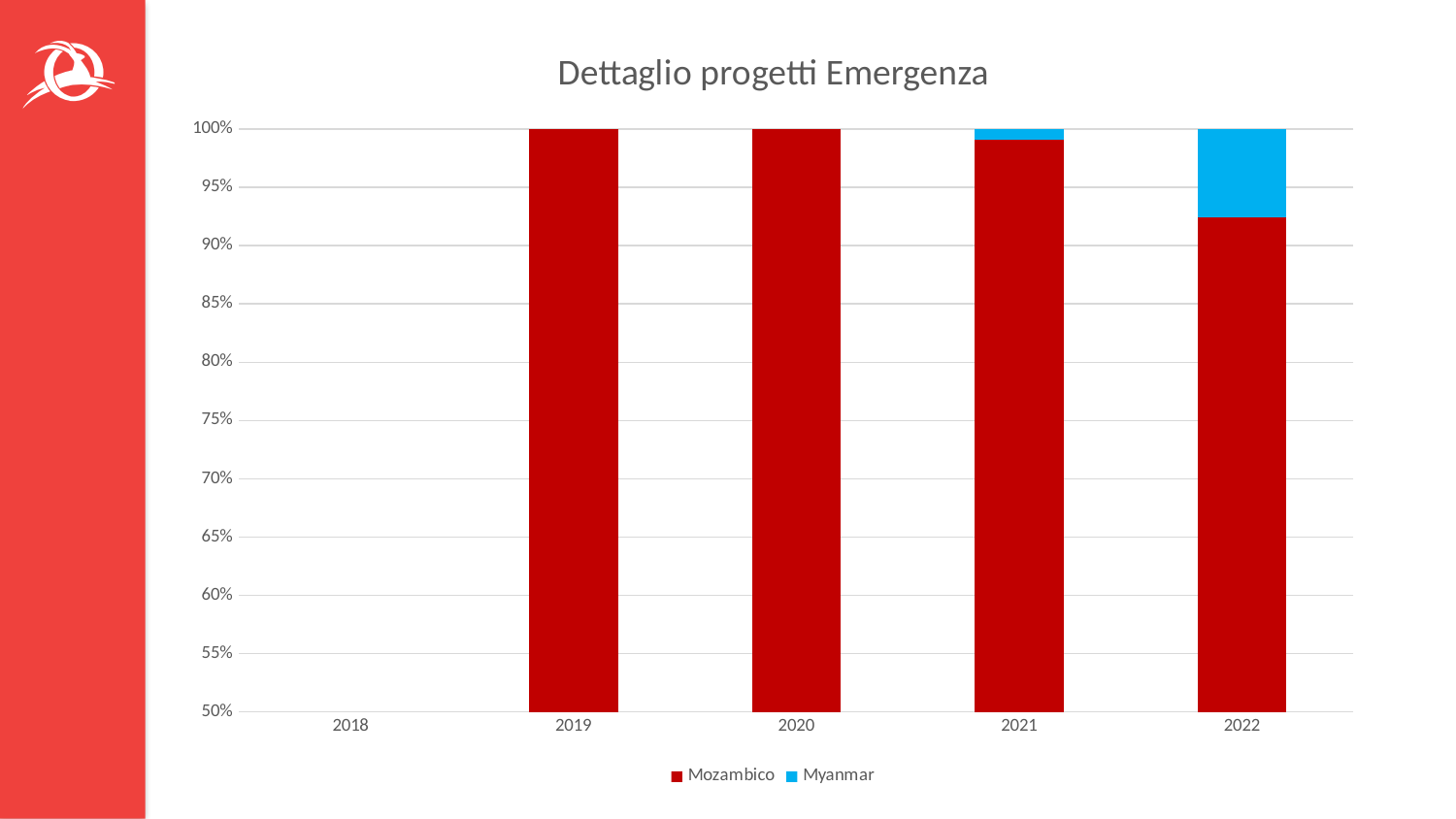
What is the value for Mozambico in 2019? 100% Is the value for Mozambico in 2021 greater or less than 95%? greater Which is larger, the Myanmar share in 2021 or in 2022? 2022 What kind of chart is shown on the slide? stacked bar chart In which year is the Myanmar share the largest? 2022 Is the value for Mozambico in 2022 greater or less than 95%? less What is the value for Mozambico in 2020? 100% Which series are listed in the legend? Mozambico and Myanmar How many years are shown on the x axis? 5 How many series does the legend list? 2 What is the title of the chart? Dettaglio progetti Emergenza Does the Mozambico share rise or fall from 2020 to 2022? fall